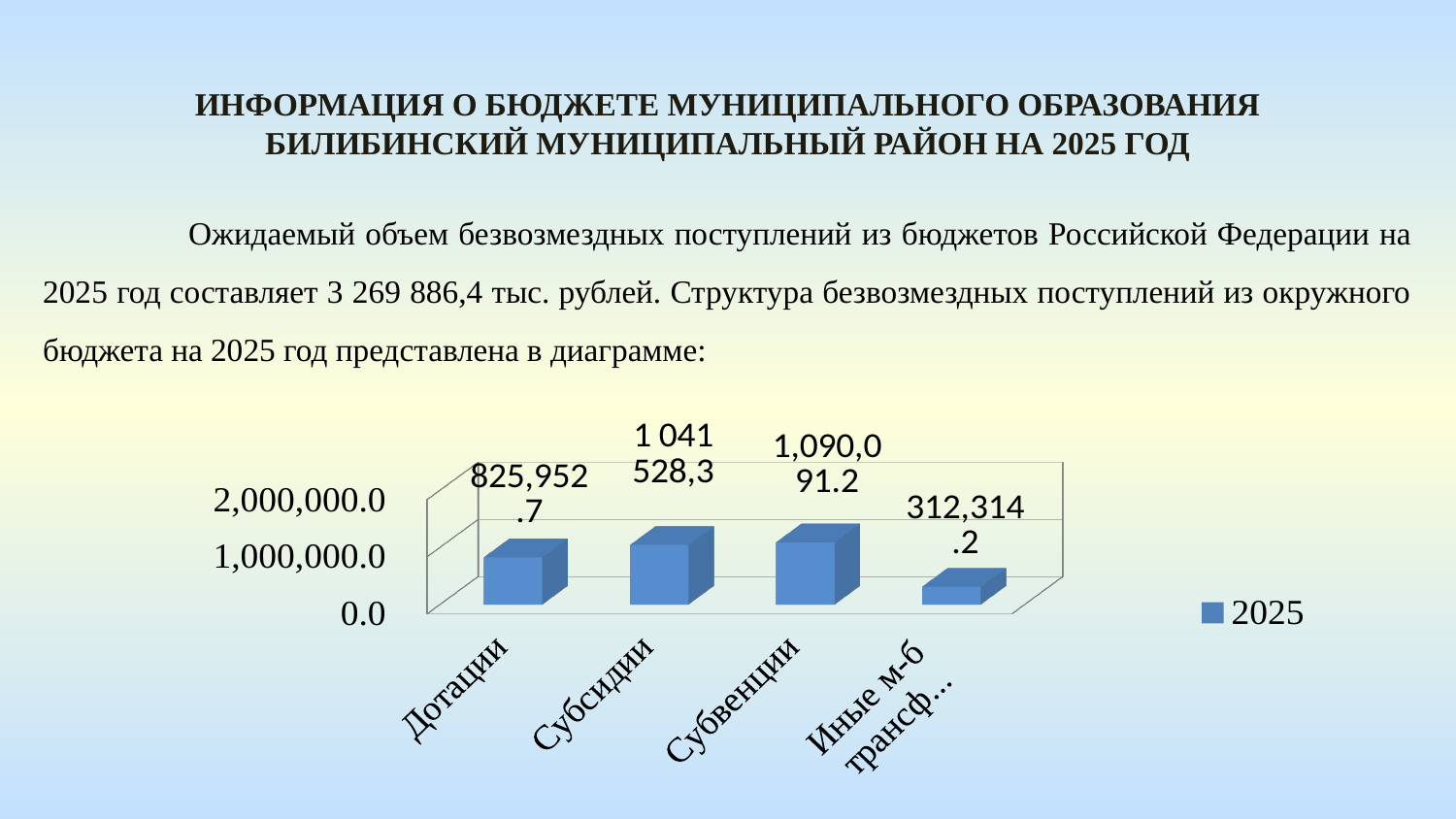
How many series does the legend list? 1 Which is larger, the value for Дотации or the value for Субсидии? Субсидии How many categories are shown on the x axis? 4 What kind of chart is shown on the slide? bar chart What is the value for Дотации? 825,952.7 Which category has the lowest value? Иные м-б трансф... What is the value for Субвенции? 1,090,091.2 What is the value for the category labelled Иные м-б трансф...? 312,314.2 Is the value for Дотации greater or less than 1,000,000.0? less What is the difference between the values for Дотации and Иные м-б трансф...? 513,638.5 Which category has the highest value? Субвенции What is the value for Субсидии? 1 041 528,3